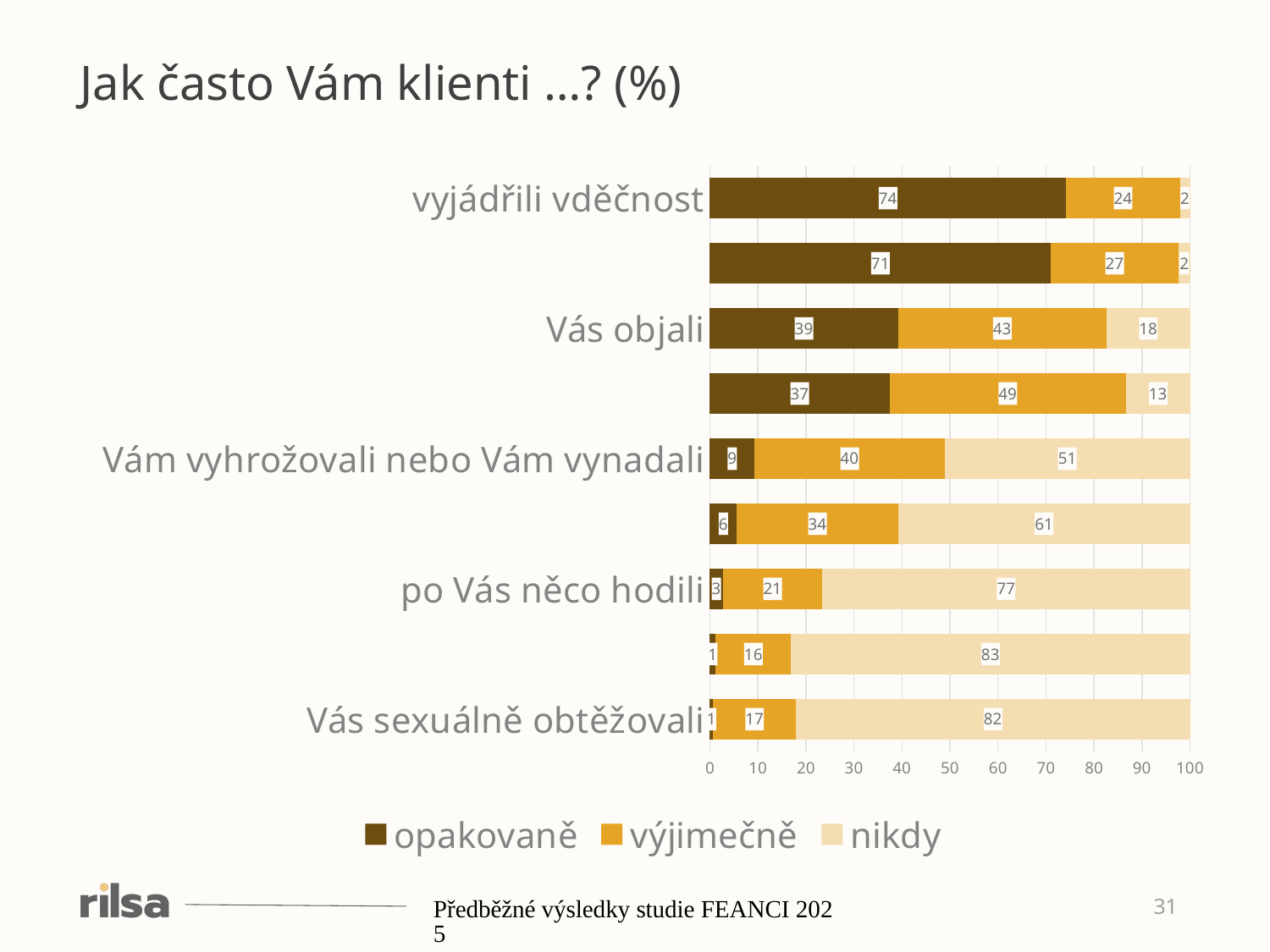
Which has a larger 'opakovaně' value: 'Vás objali' or 'Vám vyhrožovali nebo Vám vynadali'? Vás objali What is the difference between the 'nikdy' value for 'po Vás něco hodili' and the 'nikdy' value for 'Vás objali'? 59 What is the value of 'výjimečně' for 'Vás objali'? 43 What kind of chart is shown on the slide? stacked bar chart How many series does the legend list? 3 What is the value of 'opakovaně' for 'vyjádřili vděčnost'? 74 What is the value of 'nikdy' for 'Vás sexuálně obtěžovali'? 82 What is the total of the stacked bar for 'vyjádřili vděčnost'? 100 Which labeled category has the lowest 'nikdy' value? vyjádřili vděčnost What is the value of 'nikdy' for 'Vám vyhrožovali nebo Vám vynadali'? 51 Which labeled category has the highest 'opakovaně' value? vyjádřili vděčnost How many bars are plotted in the chart? 9